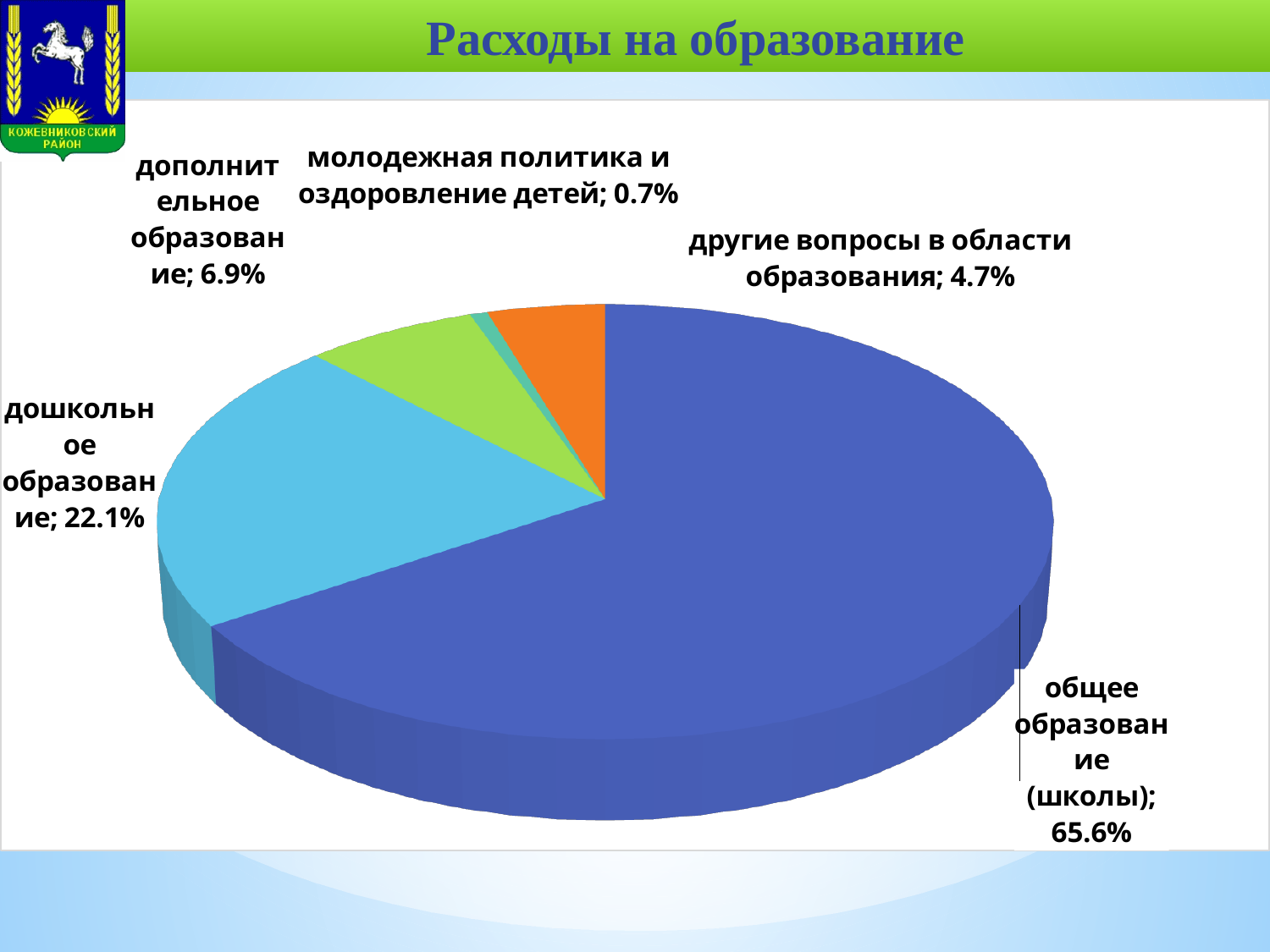
What share of education expenses goes to дополнительное образование? 6.9% What type of chart is shown on the slide? pie chart What is the title of the chart? Расходы на образование What share of education expenses goes to общее образование (школы)? 65.6% What is the difference in percentage points between общее образование (школы) and дошкольное образование? 43.5 What share of education expenses goes to молодежная политика и оздоровление детей? 0.7% What share of education expenses goes to другие вопросы в области образования? 4.7% Which category has the largest share of the pie? общее образование (школы) Which category has the smallest share of the pie? молодежная политика и оздоровление детей What share of education expenses goes to дошкольное образование? 22.1% How many categories are shown in the pie chart? 5 Which is larger: the share for дополнительное образование or for другие вопросы в области образования? дополнительное образование